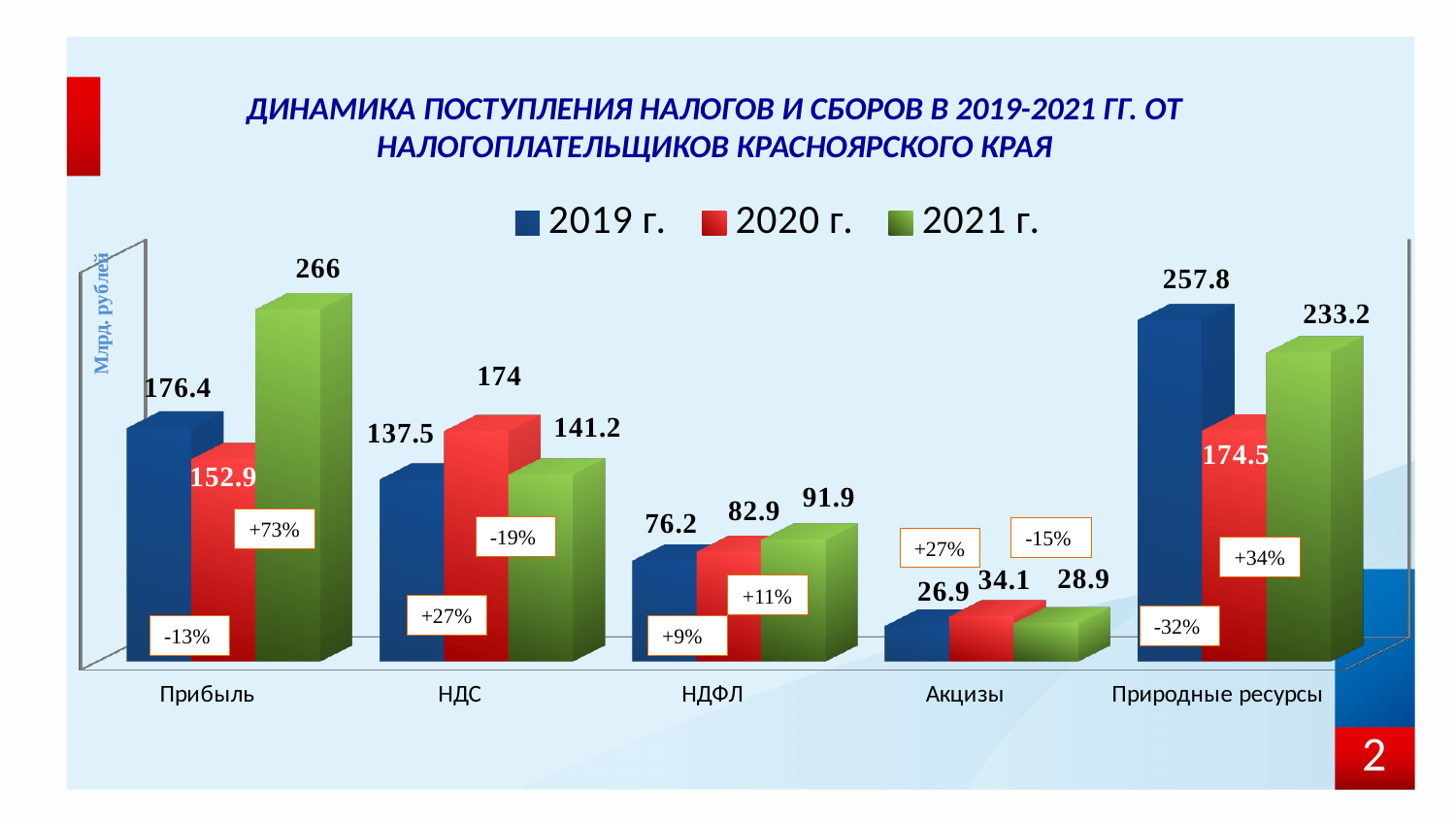
How many series does the legend list? 3 Which is larger for Природные ресурсы: the 2019 г. value or the 2021 г. value? 2019 г. Do the values for НДФЛ rise or fall from 2019 г. to 2021 г.? Rise How many categories are shown on the x axis? 5 What is the value for Природные ресурсы in the 2019 г. series? 257.8 What kind of chart is shown on the slide? Bar chart What is the difference between the 2021 г. and 2019 г. values for Прибыль? 89.6 Which category has the lowest value in the 2019 г. series? Акцизы What is the value for НДС in the 2020 г. series? 174 What is the value for Акцизы in the 2020 г. series? 34.1 Which category has the highest value in the 2021 г. series? Прибыль What is the value for Прибыль in the 2021 г. series? 266